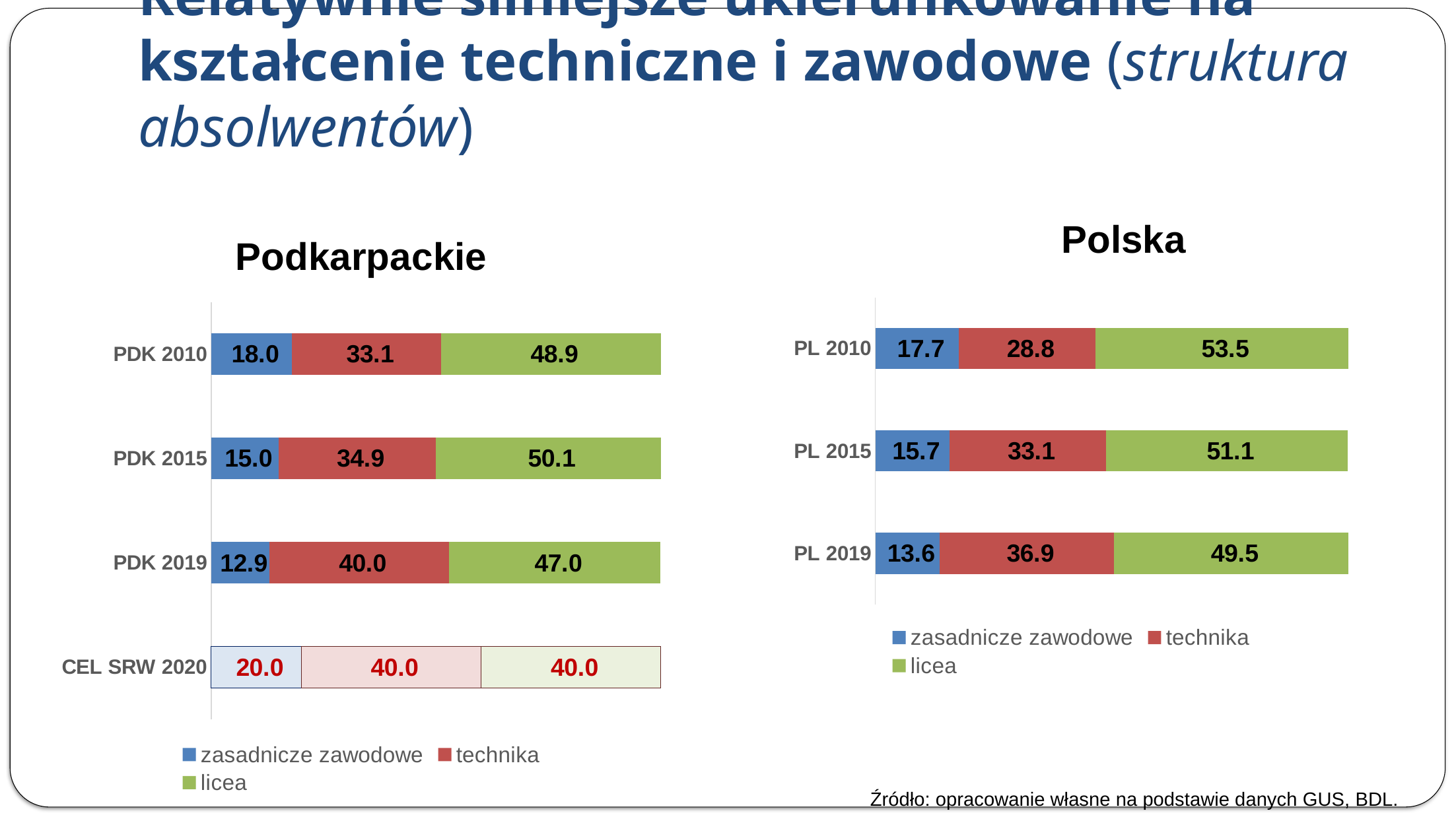
How many series does the legend of the Polska chart list? 3 What kind of chart is the Polska chart? Stacked bar chart In the Polska chart, what is the value for zasadnicze zawodowe in PL 2015? 15.7 In the Podkarpackie chart, what is the value for technika in PDK 2019? 40.0 In the Podkarpackie chart, which category has the lowest value for zasadnicze zawodowe? PDK 2019 In the Polska chart, which is larger: licea in PL 2010 or licea in PL 2019? licea in PL 2010 In the Polska chart, what is the value for licea in PL 2010? 53.5 How many categories are shown in the Podkarpackie chart? 4 In the Polska chart, what is the total of the stacked bar for PL 2019? 100.0 In the Podkarpackie chart, what is the value for zasadnicze zawodowe in CEL SRW 2020? 20.0 In the Polska chart, which category has the highest value for technika? PL 2019 In the Podkarpackie chart, what is the difference between the technika values for PDK 2019 and PDK 2010? 6.9